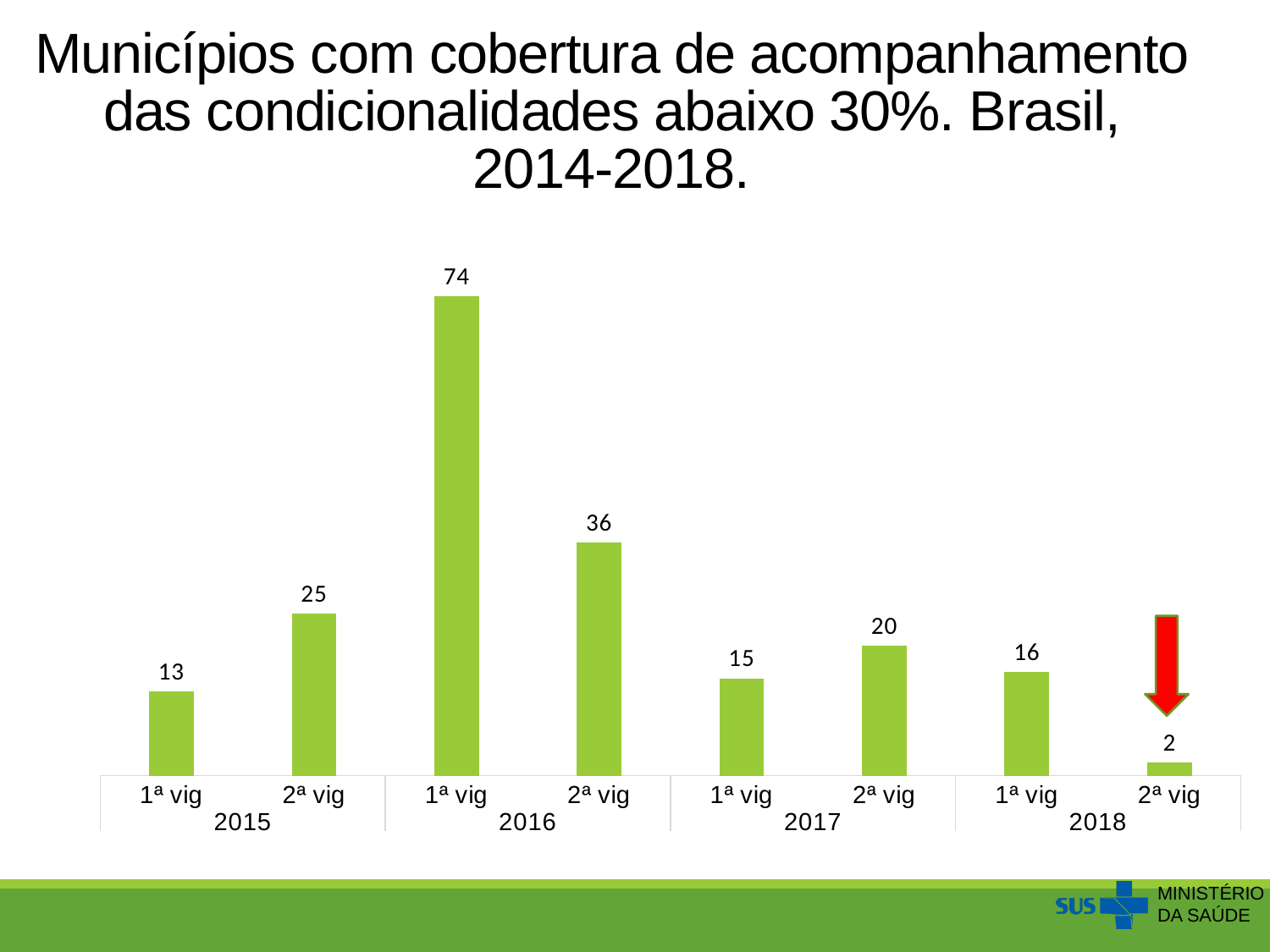
How many bars are plotted in the chart? 8 What is the value for 1ª vig 2016? 74 What is the difference between 1ª vig 2016 and 2ª vig 2016? 38 What is the value for 2ª vig 2015? 25 What is the difference between 1ª vig 2018 and 2ª vig 2018? 14 What kind of chart is shown on the slide? Bar chart What is the value for 1ª vig 2017? 15 Which period has the highest value? 1ª vig 2016 What is the value for 2ª vig 2018? 2 Which is larger, the value for 2ª vig 2017 or the value for 1ª vig 2018? 2ª vig 2017 Which period has the lowest value? 2ª vig 2018